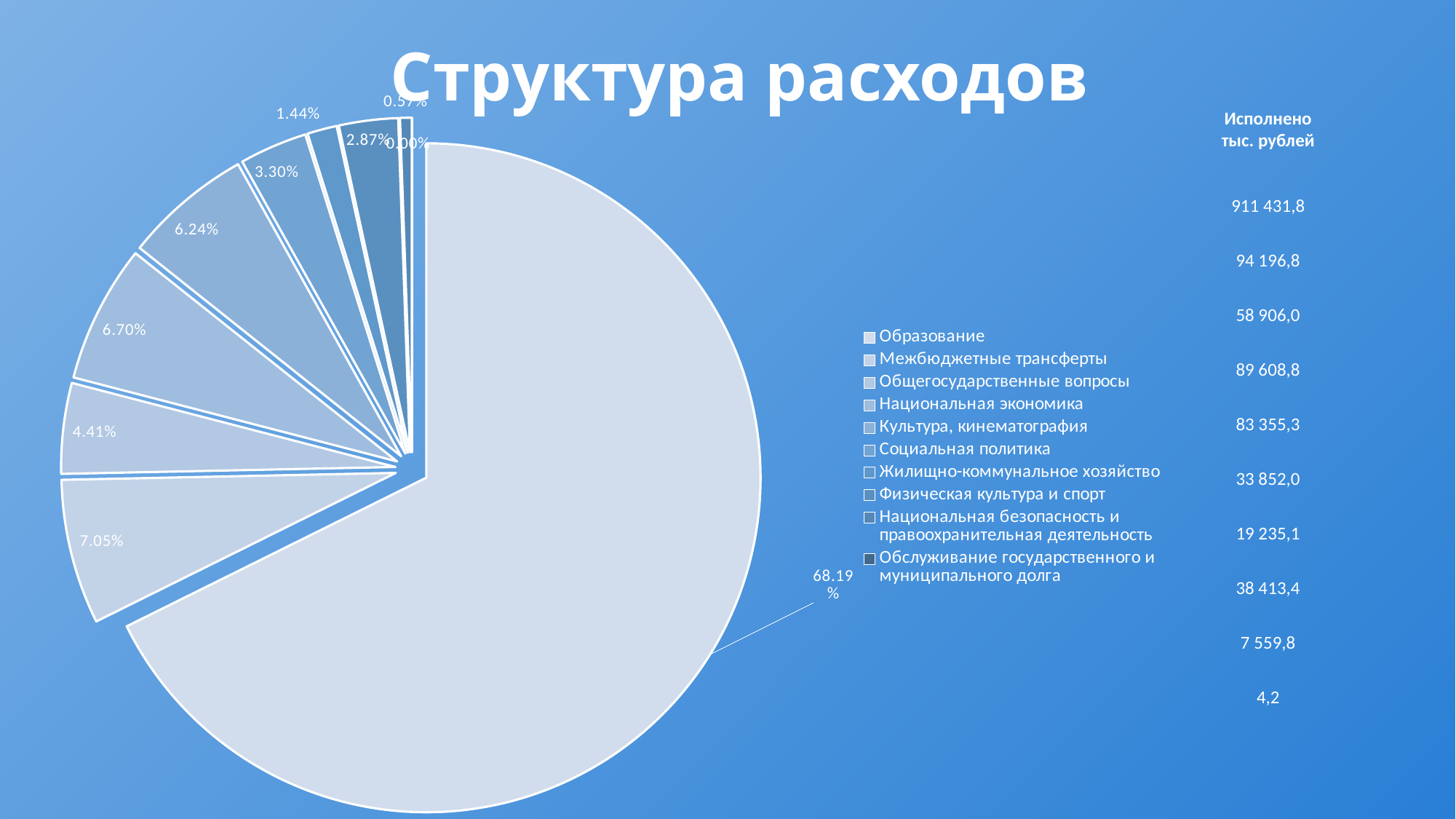
What percentage is shown for Национальная экономика? 6.70% Is the share for Образование greater or less than 50%? greater What kind of chart is shown on the slide? pie chart What is the title of the chart? Структура расходов What share of the pie does Образование have? 68.19% Which has the larger share: Национальная экономика or Культура, кинематография? Национальная экономика What percentage is shown for Культура, кинематография? 6.24% How many categories does the legend of the pie chart list? 10 What percentage is shown for Общегосударственные вопросы? 4.41% Which category has the largest slice of the pie? Образование What is the difference in percentage points between Межбюджетные трансферты and Общегосударственные вопросы? 2.64% What percentage is shown for Межбюджетные трансферты? 7.05%